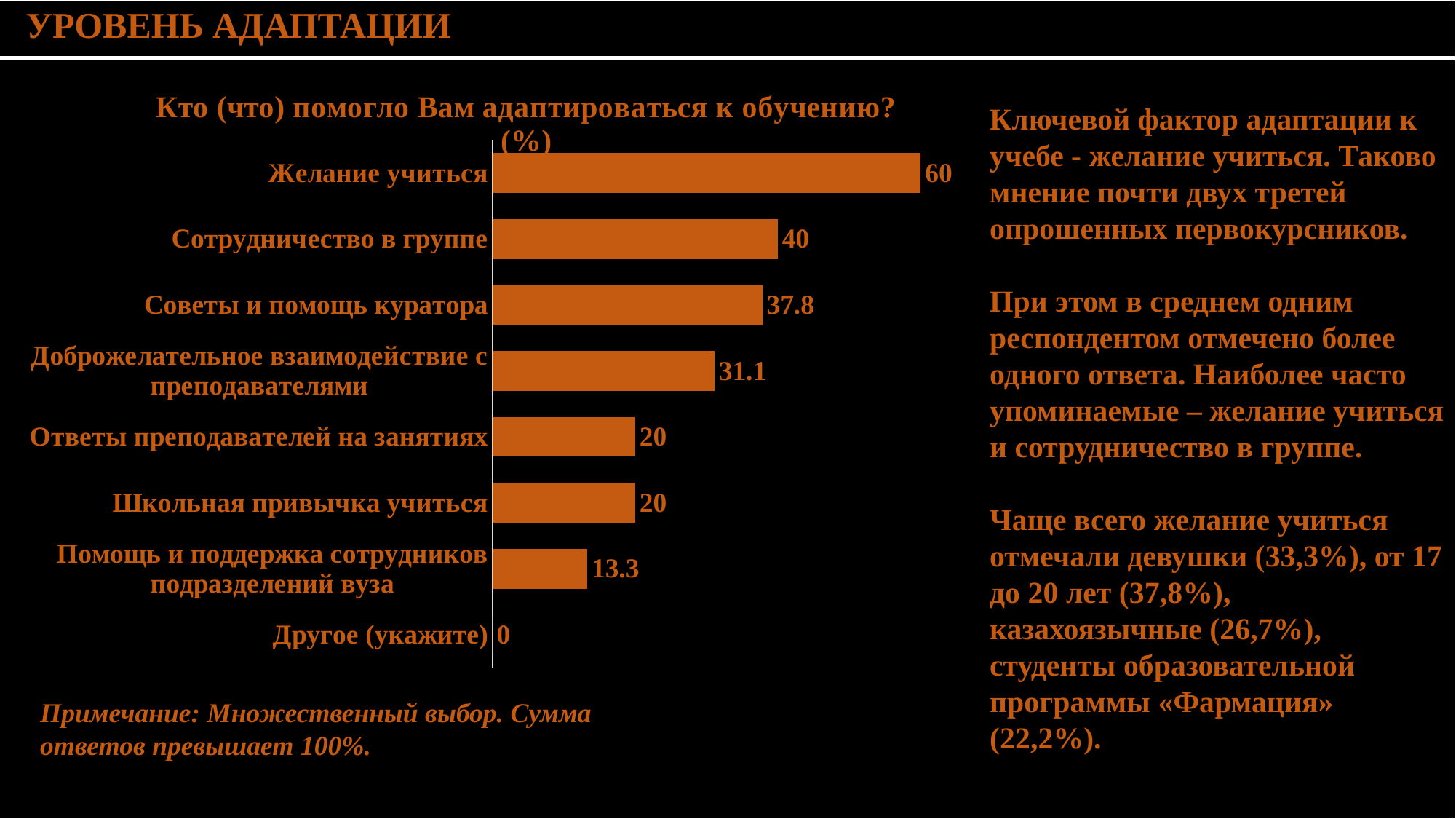
How many categories are shown in the chart? 8 What is the value for "Желание учиться"? 60 What is the difference between the values for "Желание учиться" and "Сотрудничество в группе"? 20 What is the value for "Советы и помощь куратора"? 37.8 What is the value for "Помощь и поддержка сотрудников подразделений вуза"? 13.3 What is the title of the chart? Кто (что) помогло Вам адаптироваться к обучению? (%) Which category has the highest value? Желание учиться What is the value for "Доброжелательное взаимодействие с преподавателями"? 31.1 What kind of chart is shown on the slide? Bar chart Which category has the lowest value? Другое (укажите) Which is larger: the value for "Сотрудничество в группе" or the value for "Советы и помощь куратора"? Сотрудничество в группе What is the difference between the values for "Ответы преподавателей на занятиях" and "Помощь и поддержка сотрудников подразделений вуза"? 6.7